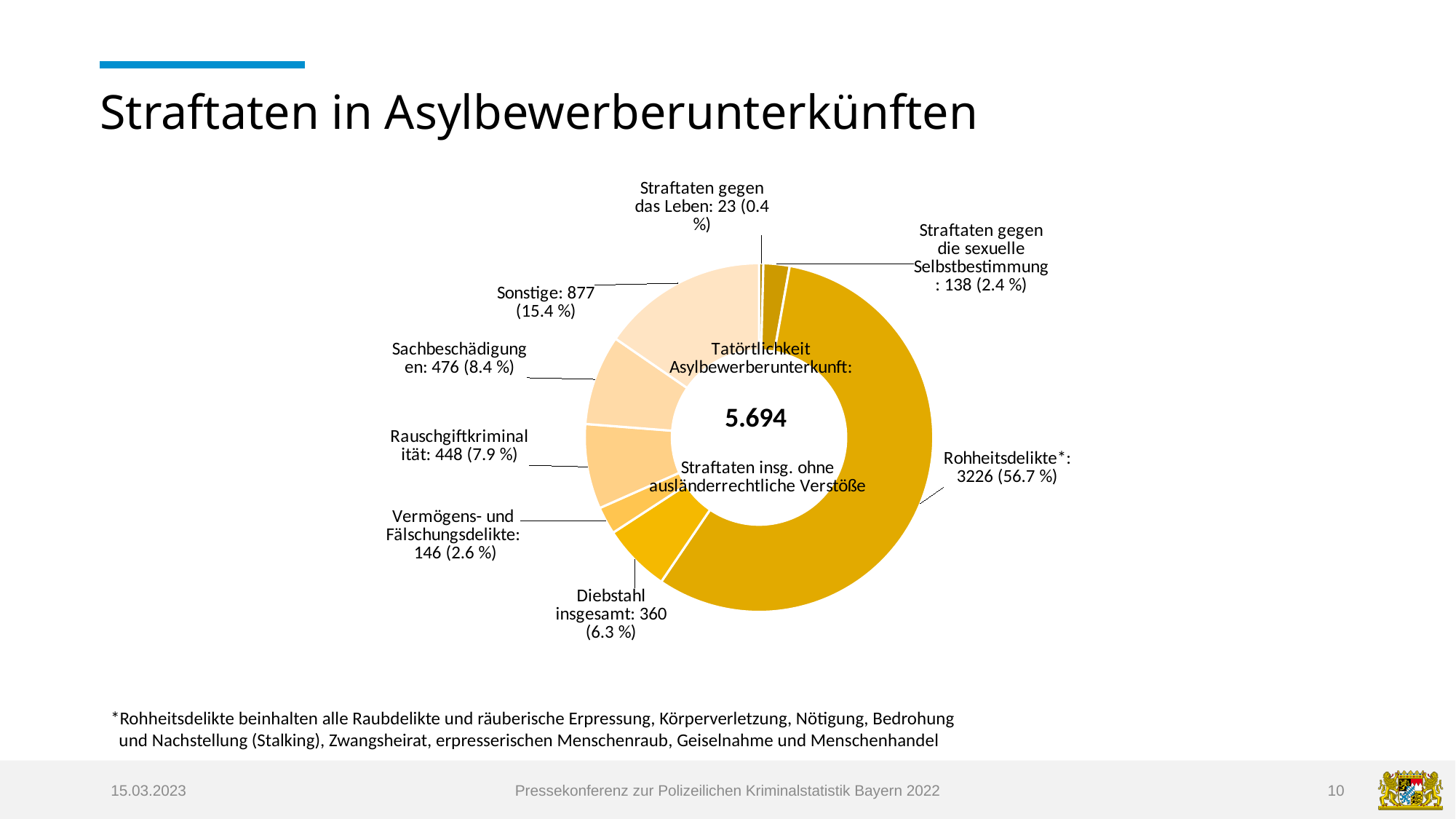
What is the value for Rauschgiftkriminalität? 448 What is the difference between Sachbeschädigungen and Rauschgiftkriminalität? 28 Which is larger: Diebstahl insgesamt or Vermögens- und Fälschungsdelikte? Diebstahl insgesamt What share of the chart do Rohheitsdelikte make up? 56.7 % What percentage is shown for Sonstige? 15.4 % What total number is shown in the centre of the donut chart? 5.694 Which category has the largest value? Rohheitsdelikte Which category has the smallest value? Straftaten gegen das Leben What is the value for Straftaten gegen die sexuelle Selbstbestimmung? 138 How many categories does the donut chart show? 8 What kind of chart is shown on the slide? Donut (pie) chart What is the value for Rohheitsdelikte? 3226